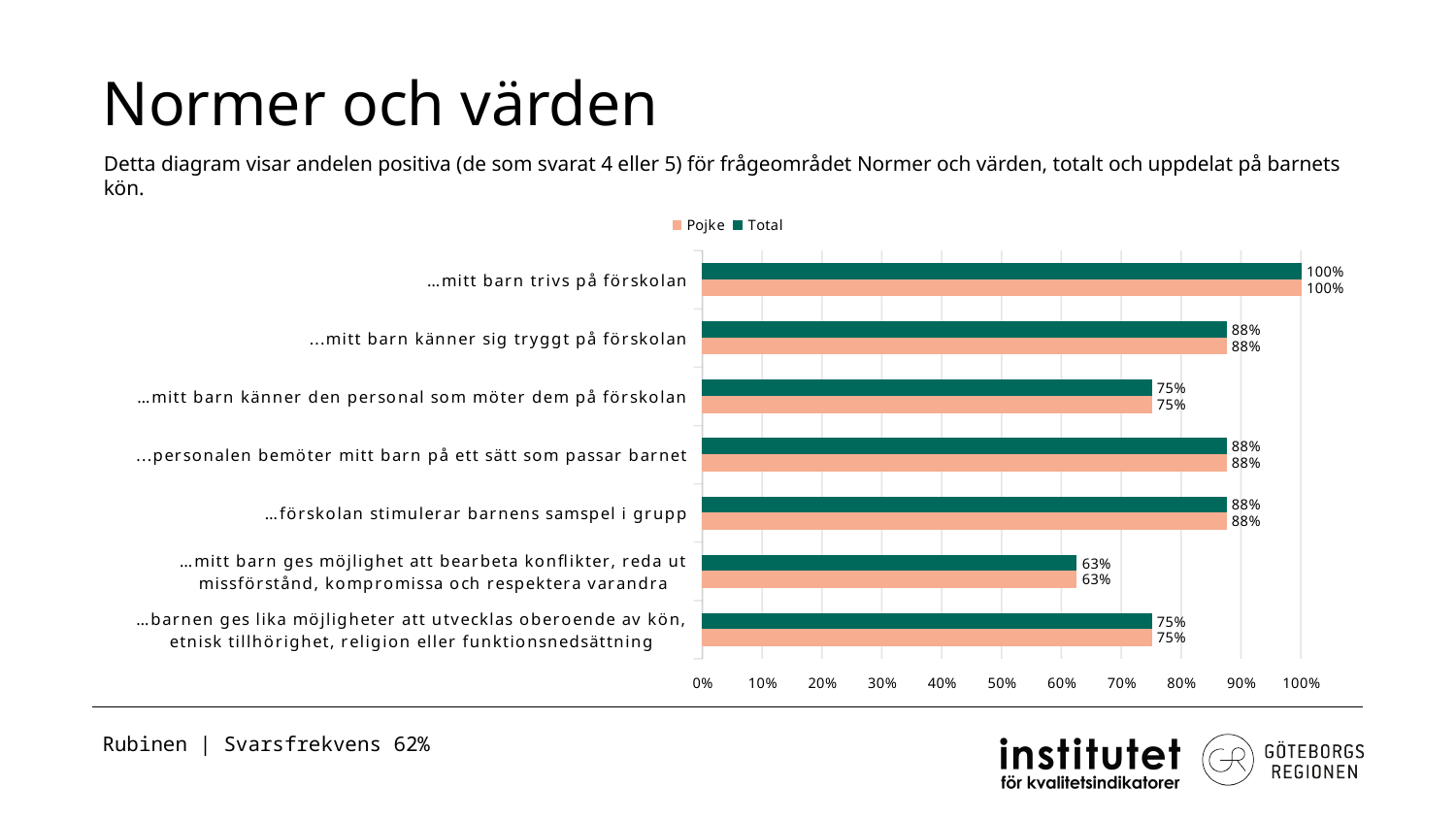
What is the Pojke value for "…mitt barn känner den personal som möter dem på förskolan"? 75% What is the difference between the Total value for "…mitt barn trivs på förskolan" and the Total value for "…mitt barn känner sig tryggt på förskolan"? 12% Which series is shown in dark green in the legend? Total Is the Total value for "…personalen bemöter mitt barn på ett sätt som passar barnet" greater or less than 80%? greater What is the Total value for "…mitt barn trivs på förskolan"? 100% How many series does the legend list? 2 What is the Total value for "…mitt barn ges möjlighet att bearbeta konflikter, reda ut missförstånd, kompromissa och respektera varandra"? 63% Which category has the lowest Pojke value? …mitt barn ges möjlighet att bearbeta konflikter, reda ut missförstånd, kompromissa och respektera varandra Which category has the highest Total value? …mitt barn trivs på förskolan Which is larger: the Pojke value for "…förskolan stimulerar barnens samspel i grupp" or the Pojke value for "…barnen ges lika möjligheter att utvecklas oberoende av kön, etnisk tillhörighet, religion eller funktionsnedsättning"? …förskolan stimulerar barnens samspel i grupp What kind of chart is shown on the slide? bar chart How many categories are plotted in the chart? 7